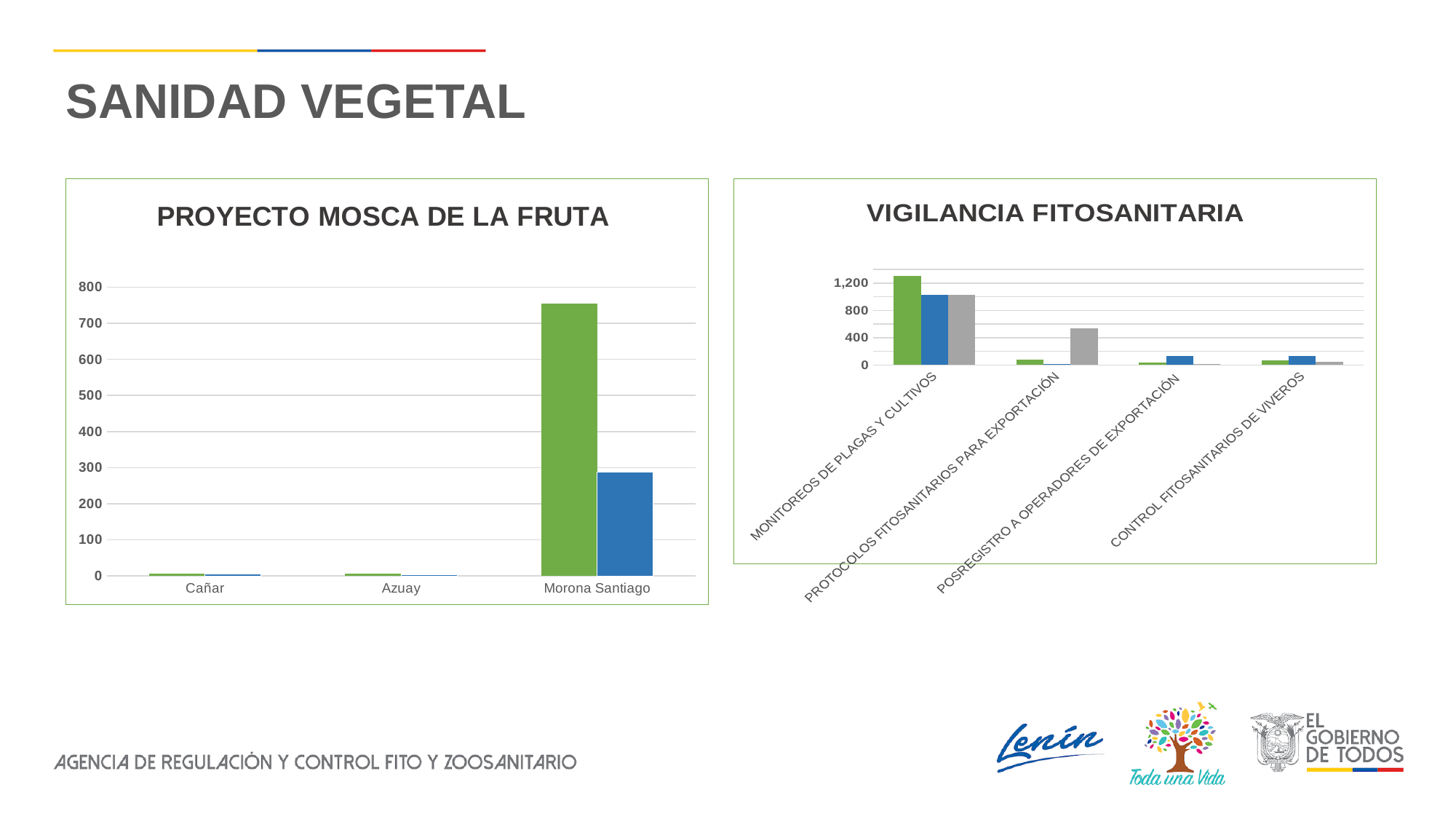
In the PROYECTO MOSCA DE LA FRUTA chart, is the blue bar for Morona Santiago greater or less than 400? less In the PROYECTO MOSCA DE LA FRUTA chart, how many categories are shown on the x axis? 3 What kind of chart is the PROYECTO MOSCA DE LA FRUTA chart on the left? Bar chart In the PROYECTO MOSCA DE LA FRUTA chart, which bar for Morona Santiago is larger, the green one or the blue one? The green one In the VIGILANCIA FITOSANITARIA chart, which category has the highest bar? MONITOREOS DE PLAGAS Y CULTIVOS In the PROYECTO MOSCA DE LA FRUTA chart, is the green bar for Cañar greater or less than 100? less In the PROYECTO MOSCA DE LA FRUTA chart, which category has the highest bar? Morona Santiago What is the title of the chart on the right side of the slide? VIGILANCIA FITOSANITARIA In the PROYECTO MOSCA DE LA FRUTA chart, is the green bar for Morona Santiago greater or less than 700? greater In the VIGILANCIA FITOSANITARIA chart, how many categories are shown on the x axis? 4